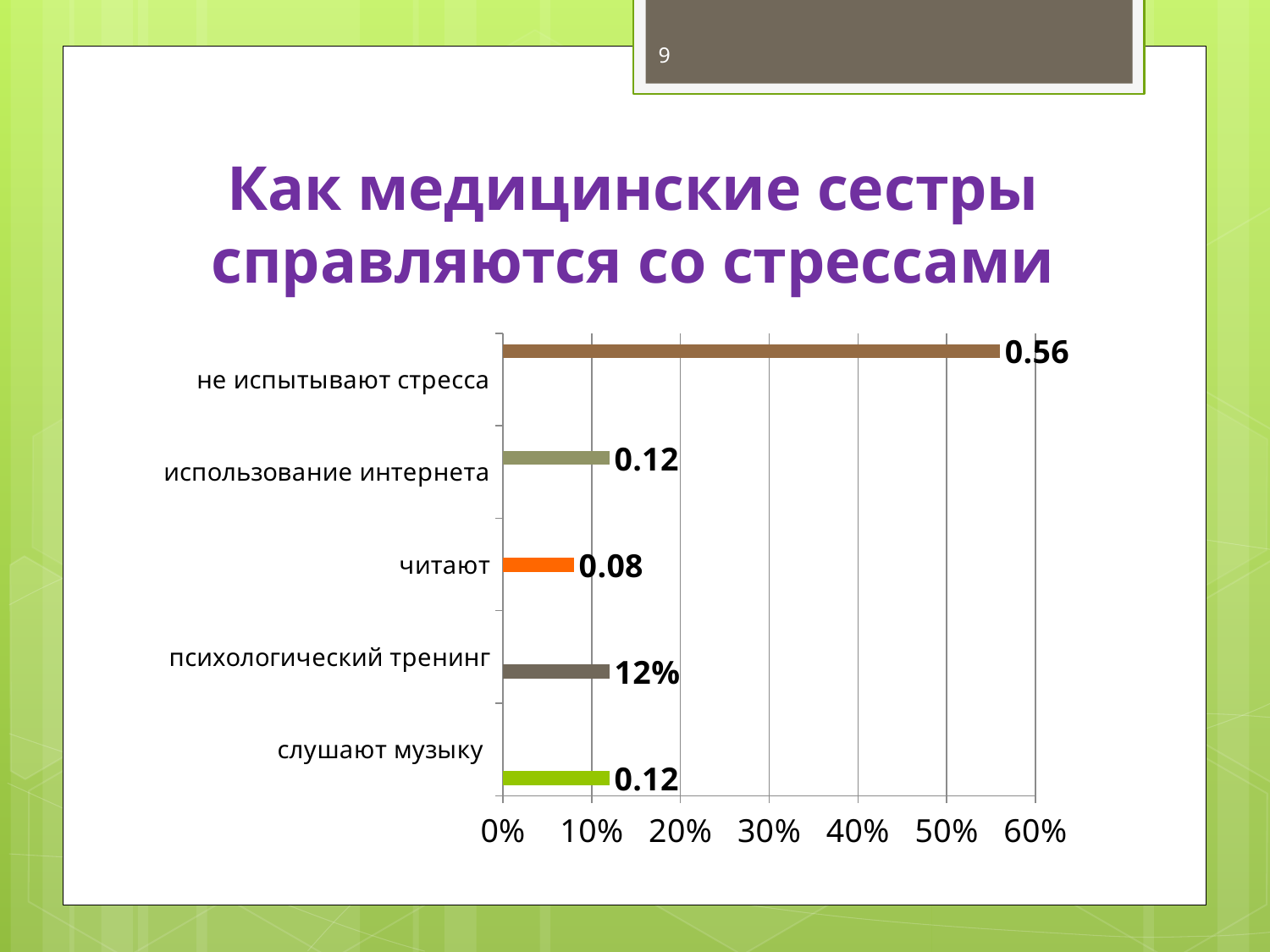
What value is shown for the category "психологический тренинг"? 12% What value is shown for the category "не испытывают стресса"? 0.56 Which category has the highest value? не испытывают стресса What kind of chart is shown on the slide? bar chart What is the difference between the values for "не испытывают стресса" and "использование интернета"? 0.44 Which is larger: the value for "использование интернета" or the value for "читают"? использование интернета How many categories are shown in the chart? 5 What is the title of the slide? Как медицинские сестры справляются со стрессами What value is shown for the category "слушают музыку"? 0.12 Is the value for "не испытывают стресса" greater or less than 50%? greater Which category has the lowest value? читают What value is shown for the category "читают"? 0.08